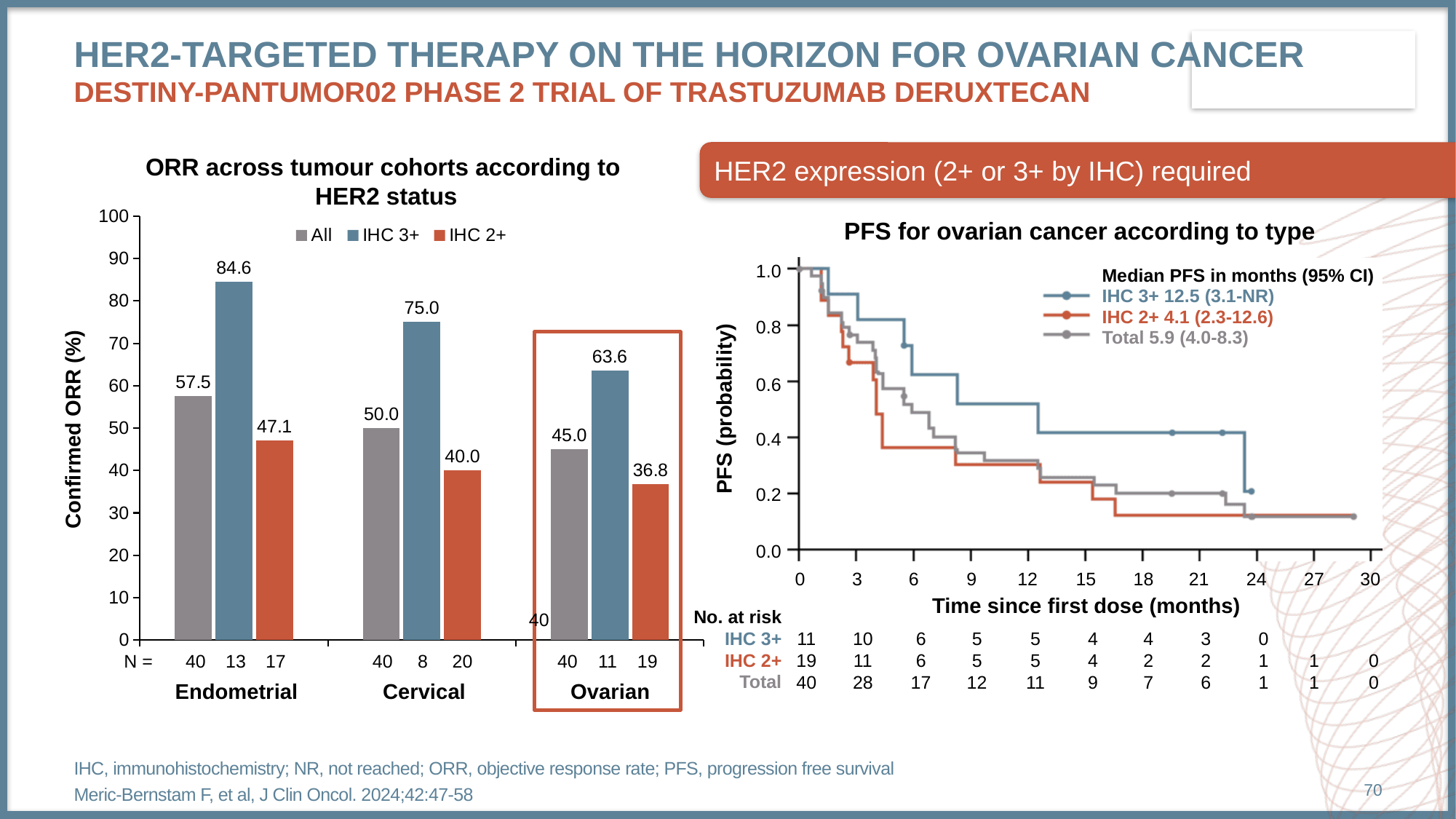
In the 'ORR across tumour cohorts according to HER2 status' chart, what is the confirmed ORR for All patients in the Cervical cohort? 50.0 In the 'PFS for ovarian cancer according to type' chart, what is the median PFS in months for IHC 2+? 4.1 (2.3-12.6) What kind of chart is the 'ORR across tumour cohorts according to HER2 status' chart? Bar chart How many series does the legend of the 'ORR across tumour cohorts according to HER2 status' chart list? 3 In the 'ORR across tumour cohorts according to HER2 status' chart, what is the difference between the IHC 3+ and IHC 2+ ORR in the Ovarian cohort? 26.8 In the 'PFS for ovarian cancer according to type' chart, how many IHC 3+ patients are at risk at 0 months? 11 In the 'ORR across tumour cohorts according to HER2 status' chart, what is the confirmed ORR for IHC 2+ in the Ovarian cohort? 36.8 In the 'ORR across tumour cohorts according to HER2 status' chart, which tumour cohort has the highest IHC 3+ ORR? Endometrial How many tumour cohorts are shown on the x axis of the 'ORR across tumour cohorts according to HER2 status' chart? 3 In the 'ORR across tumour cohorts according to HER2 status' chart, what is the confirmed ORR for IHC 3+ in the Endometrial cohort? 84.6 In the 'ORR across tumour cohorts according to HER2 status' chart, is the IHC 3+ ORR higher in the Cervical or the Ovarian cohort? Cervical In the 'ORR across tumour cohorts according to HER2 status' chart, which tumour cohort has the lowest IHC 2+ ORR? Ovarian